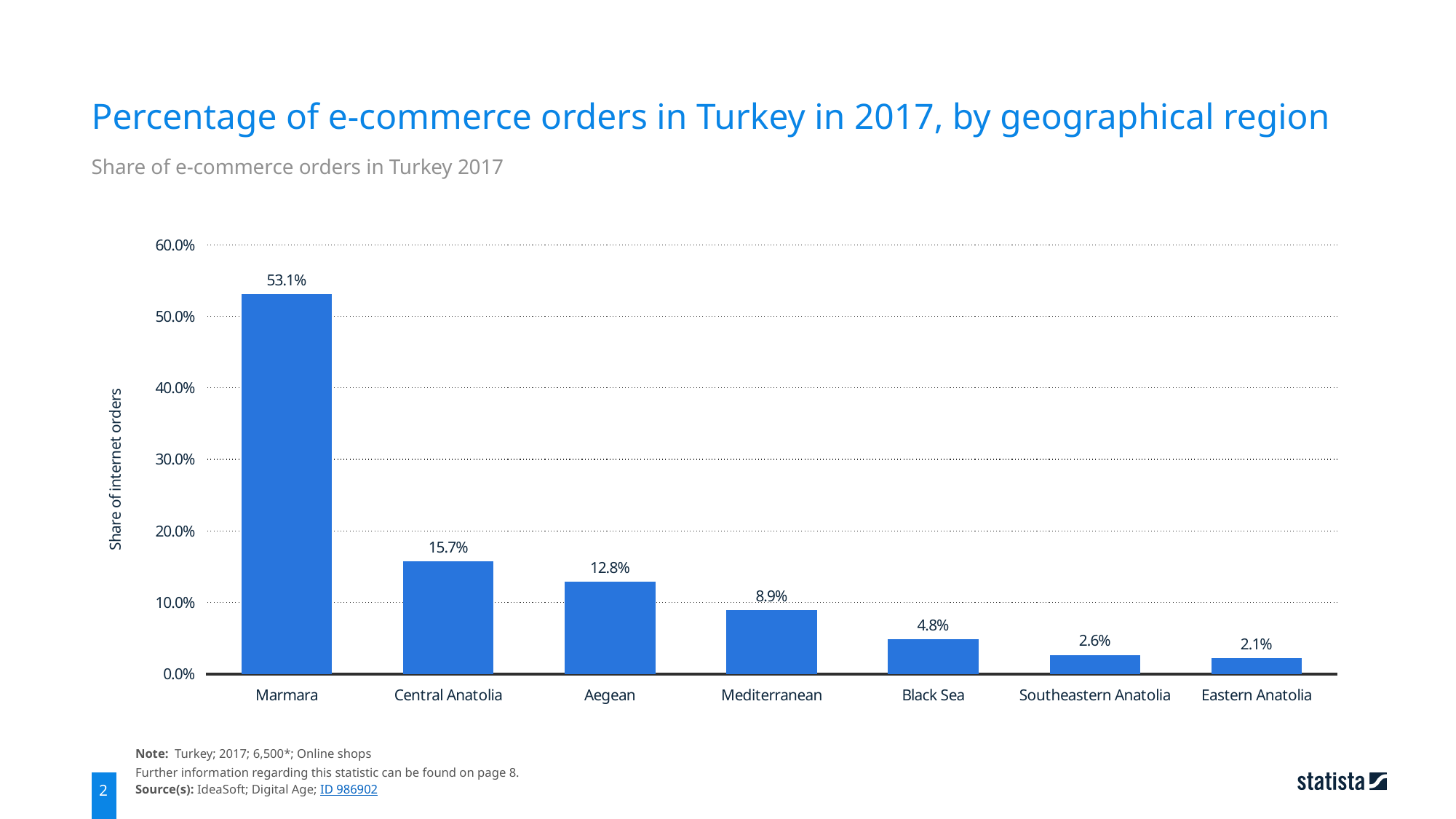
What is the share of e-commerce orders for Mediterranean? 8.9% What kind of chart is shown on the slide? Bar chart What is the difference in share between Marmara and Black Sea? 48.3% What is the label of the vertical axis? Share of internet orders Which region has the highest share of e-commerce orders? Marmara What is the share of e-commerce orders for Marmara? 53.1% Which region has the lowest share of e-commerce orders? Eastern Anatolia What is the difference in share between Central Anatolia and Aegean? 2.9% How many regions are shown in the chart? 7 Is the value for Central Anatolia greater or less than 20.0%? less What is the share of e-commerce orders for Southeastern Anatolia? 2.6% Which has a larger share of e-commerce orders, Aegean or Mediterranean? Aegean